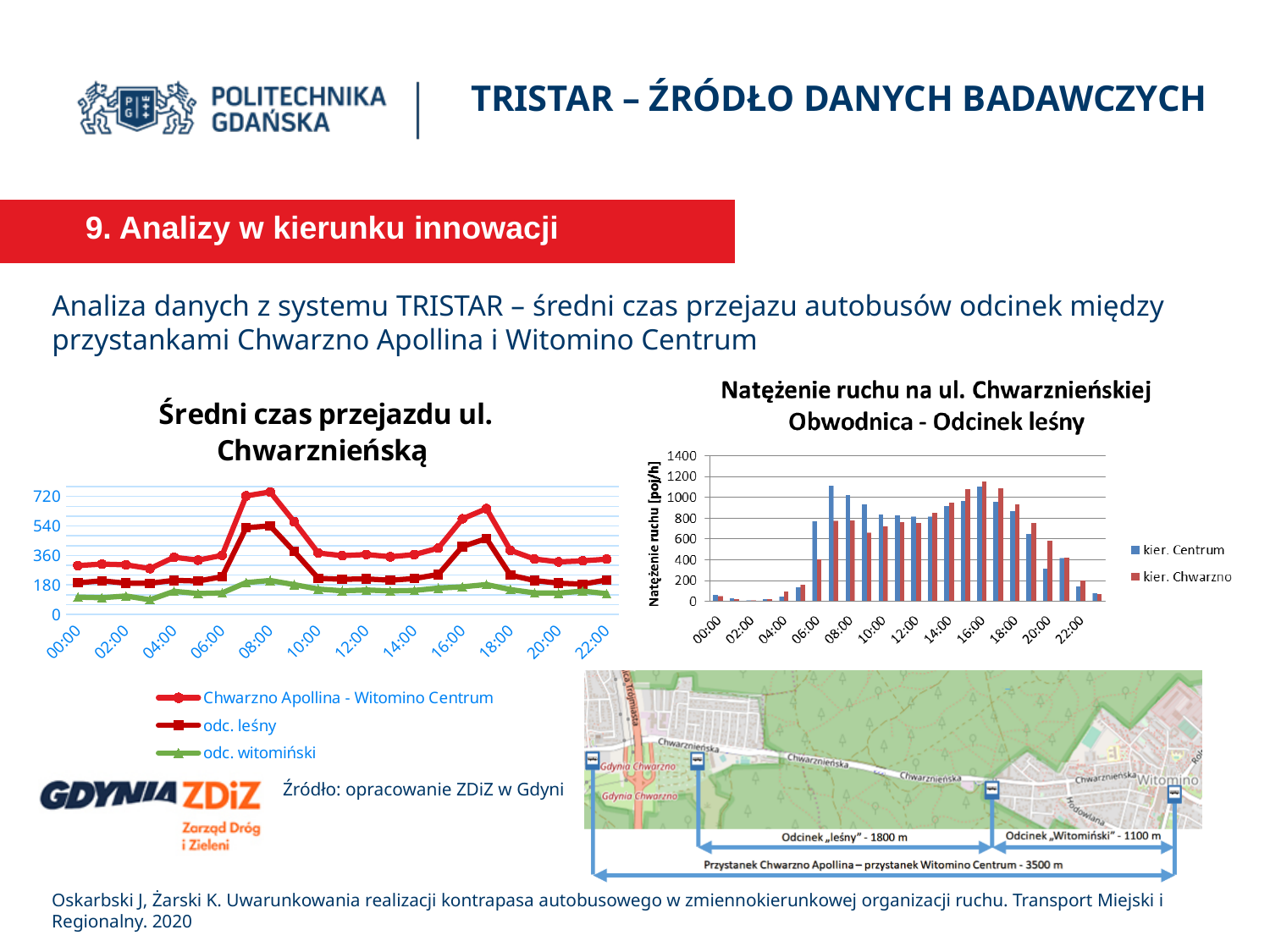
What kind of chart is "Natężenie ruchu na ul. Chwarznieńskiej Obwodnica - Odcinek leśny"? bar chart In "Średni czas przejazdu ul. Chwarznieńską", is the value for Chwarzno Apollina - Witomino Centrum at 08:00 greater or less than 540? greater How many series does the legend of "Natężenie ruchu na ul. Chwarznieńskiej Obwodnica - Odcinek leśny" list? 2 In "Średni czas przejazdu ul. Chwarznieńską", which series has the lowest values across the day? odc. witomiński In "Średni czas przejazdu ul. Chwarznieńską", which series has the highest values across the day? Chwarzno Apollina - Witomino Centrum In "Średni czas przejazdu ul. Chwarznieńską", does the Chwarzno Apollina - Witomino Centrum series rise or fall between 08:00 and 10:00? fall What kind of chart is "Średni czas przejazdu ul. Chwarznieńską"? line chart In "Natężenie ruchu na ul. Chwarznieńskiej Obwodnica - Odcinek leśny", which is larger at 07:00, kier. Centrum or kier. Chwarzno? kier. Centrum In "Natężenie ruchu na ul. Chwarznieńskiej Obwodnica - Odcinek leśny", is the kier. Centrum value at 07:00 greater or less than 1000? greater In "Średni czas przejazdu ul. Chwarznieńską", is the value for odc. witomiński at 08:00 greater or less than 360? less How many series does the legend of "Średni czas przejazdu ul. Chwarznieńską" list? 3